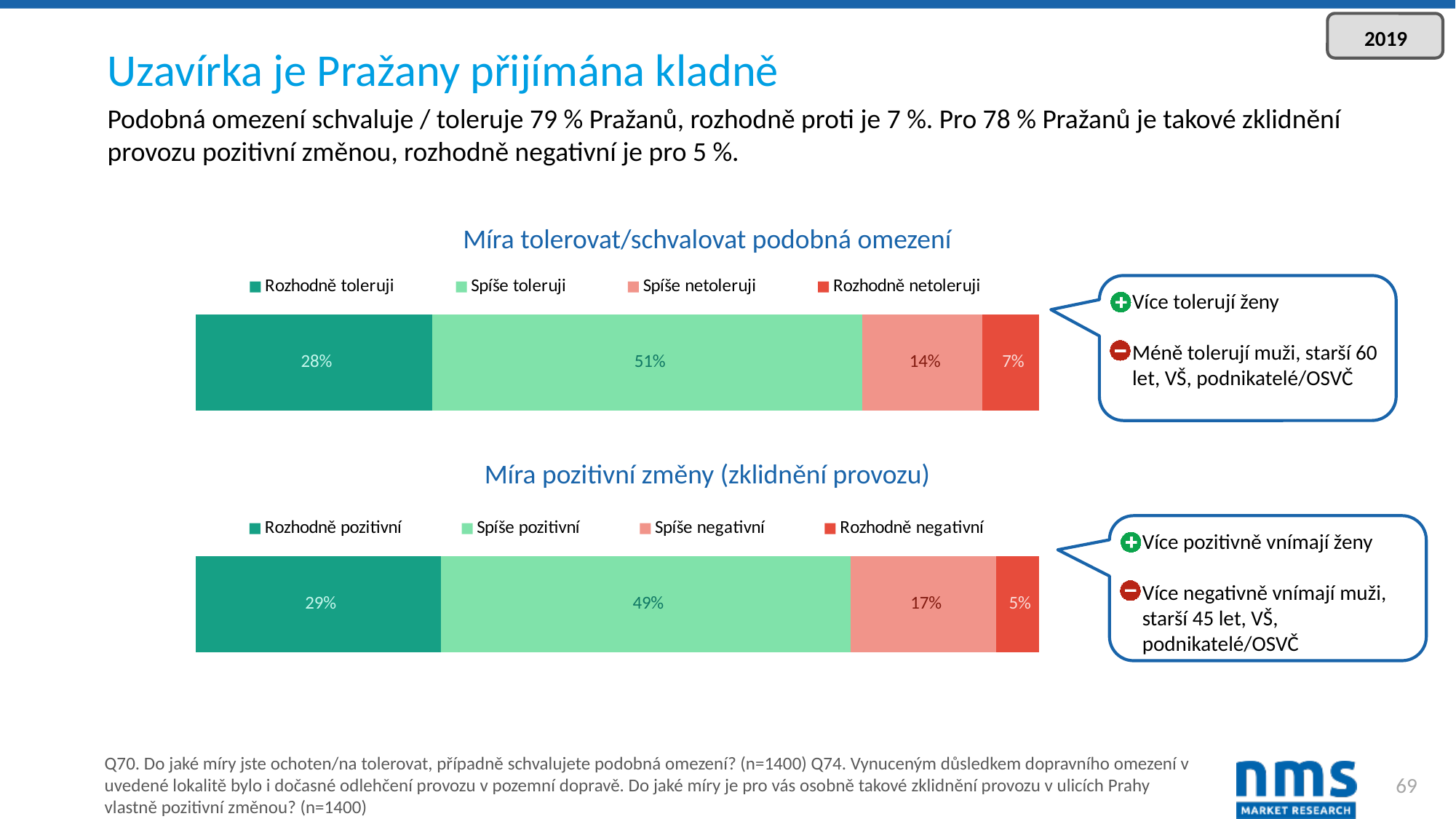
In the chart 'Míra pozitivní změny (zklidnění provozu)', which is larger: 'Spíše negativní' or 'Rozhodně negativní'? Spíše negativní What kind of chart is 'Míra pozitivní změny (zklidnění provozu)'? Stacked bar chart In the chart 'Míra tolerovat/schvalovat podobná omezení', what is the value for 'Spíše netoleruji'? 14% How many series does the legend of the chart 'Míra tolerovat/schvalovat podobná omezení' list? 4 In the chart 'Míra pozitivní změny (zklidnění provozu)', what is the value for 'Rozhodně negativní'? 5% In the chart 'Míra tolerovat/schvalovat podobná omezení', what colour is the 'Rozhodně netoleruji' segment? Red In the chart 'Míra pozitivní změny (zklidnění provozu)', what is the value for 'Spíše pozitivní'? 49% In the chart 'Míra tolerovat/schvalovat podobná omezení', what is the difference between 'Spíše toleruji' and 'Rozhodně toleruji'? 23 percentage points In the chart 'Míra pozitivní změny (zklidnění provozu)', what is the combined total of 'Rozhodně pozitivní' and 'Spíše pozitivní'? 78% In the chart 'Míra pozitivní změny (zklidnění provozu)', which series has the lowest value? Rozhodně negativní In the chart 'Míra tolerovat/schvalovat podobná omezení', what is the value for 'Rozhodně toleruji'? 28% In the chart 'Míra tolerovat/schvalovat podobná omezení', which series has the highest value? Spíše toleruji